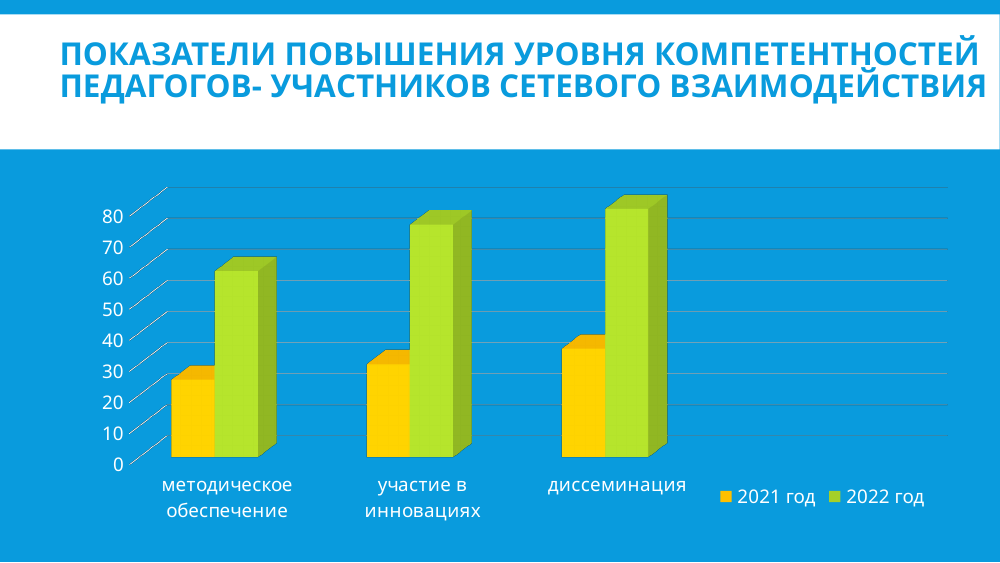
Which is larger in диссеминация: the value for 2021 год or for 2022 год? 2022 год Is the value for 2022 год in диссеминация greater or less than 70? greater Is the value for 2021 год in методическое обеспечение greater or less than 40? less Is the value for 2022 год in участие в инновациях greater or less than 60? greater How many categories are shown on the x axis? 3 What kind of chart is shown on the slide? bar chart How many series does the legend list? 2 Which category has the highest value for 2022 год? диссеминация Which category has the lowest value for 2022 год? методическое обеспечение Which colour represents the 2021 год series in the legend? yellow Which category has the lowest value for 2021 год? методическое обеспечение Do the values for 2022 год rise or fall from left to right across the categories? rise